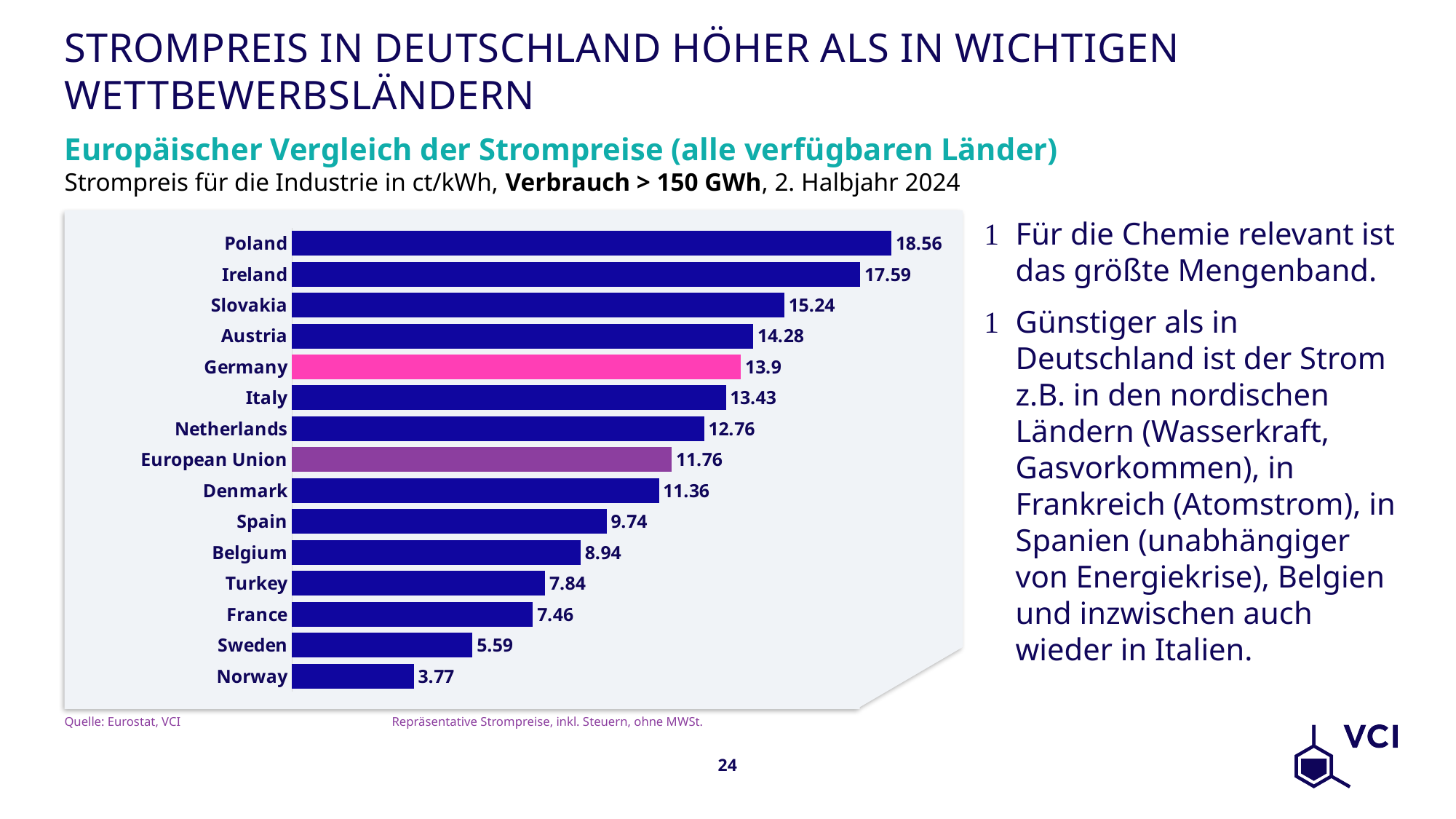
Which country has the highest electricity price in the chart? Poland How many countries or regions are shown in the chart? 15 What is the difference between the values for Germany and France? 6.44 Which has a higher value, Austria or Italy? Austria What is the difference between the values for Poland and Germany? 4.66 What is the electricity price shown for Germany? 13.9 What is the value shown for the European Union? 11.76 What kind of chart is shown on the slide? Bar chart What is the value shown for Norway? 3.77 Which bar in the chart is highlighted in pink? Germany Which has a higher value, Sweden or Turkey? Turkey Which country has the lowest electricity price in the chart? Norway